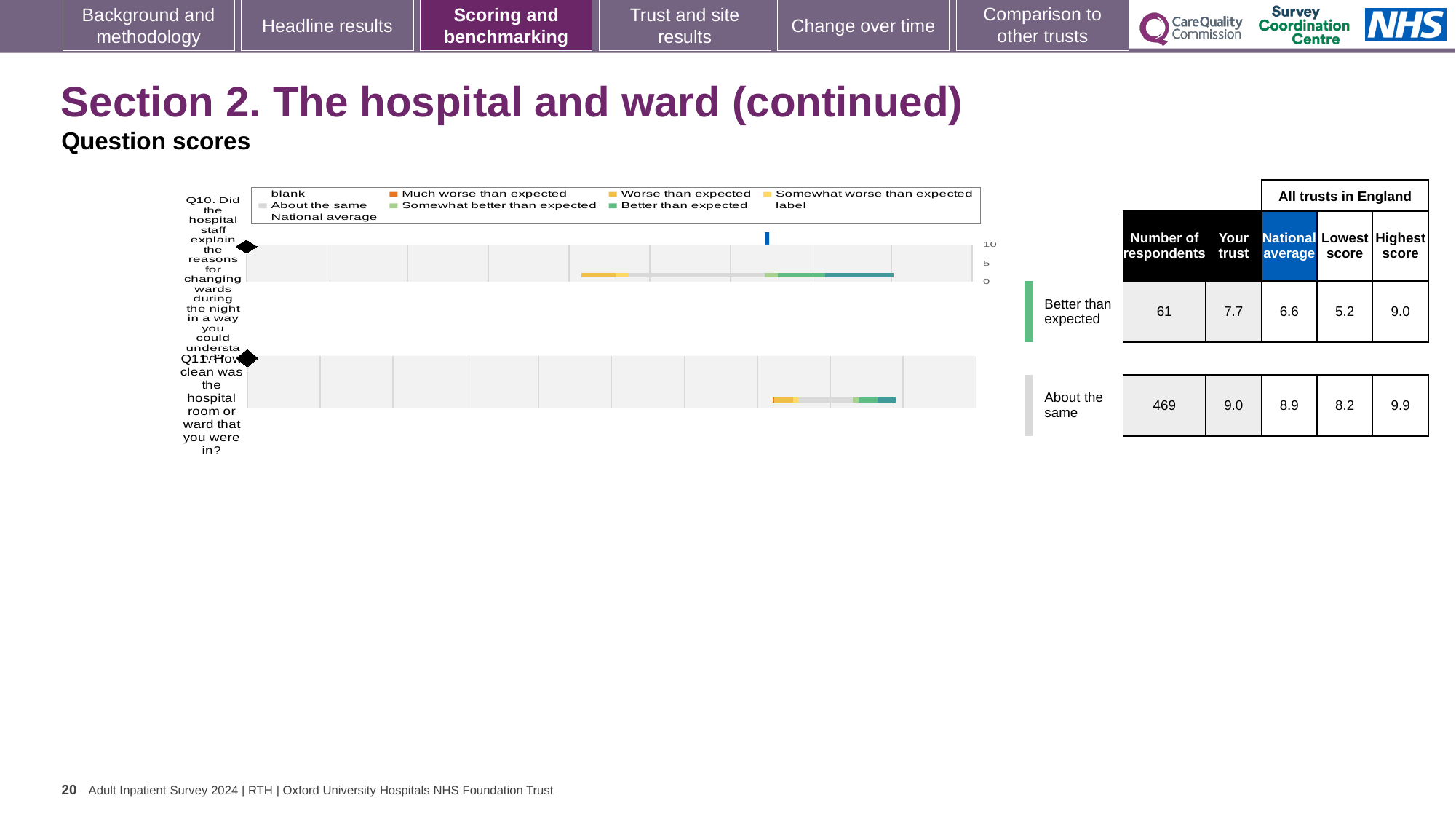
What kind of chart is shown on the slide? bar chart How many respondents answered Q11 according to the table? 469 What is the maximum value shown on the chart's axis? 10 Which question number is plotted in the top row of the chart? Q10 According to the table beside the chart, what is the 'Your trust' score for Q10 (explaining reasons for changing wards during the night)? 7.7 How many entries does the chart legend list? 9 Which benchmark category is Q11 rated as? About the same What is the difference between the 'Your trust' score and the national average for Q10? 1.1 Which benchmark category is Q10 rated as? Better than expected What is the national average score for Q10 shown in the table? 6.6 How many survey questions are plotted in the chart? 2 According to the table beside the chart, what is the 'Your trust' score for Q11 (how clean was the hospital room or ward)? 9.0